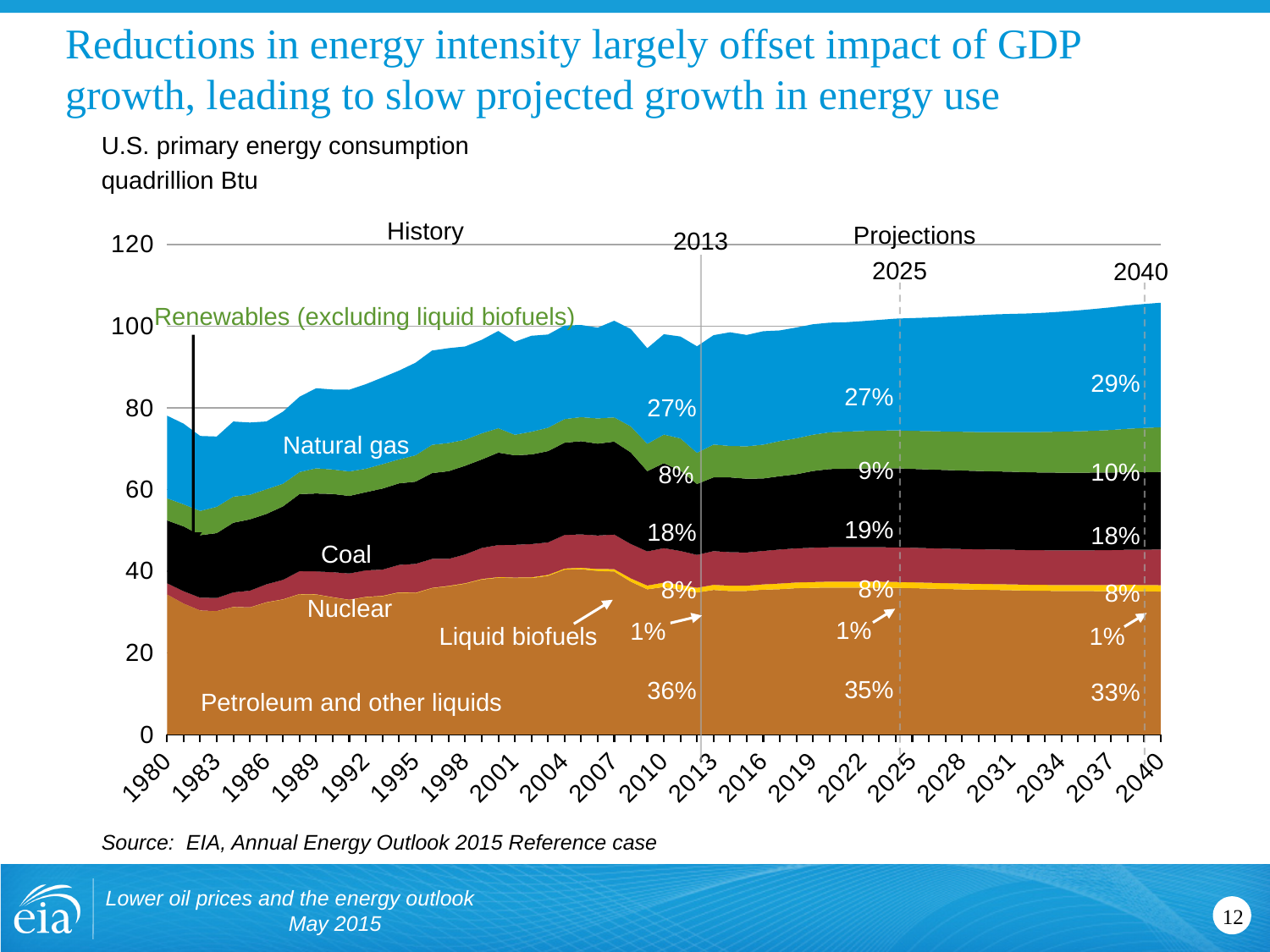
Is total U.S. primary energy consumption in 2040 greater or less than 100 quadrillion Btu? greater By how many percentage points does the natural gas share change between 2013 and 2040? 2 percentage points Which energy source has the largest share of U.S. primary energy consumption in 2013? Petroleum and other liquids What share of U.S. primary energy consumption do liquid biofuels account for in 2025? 1% Which energy source has the smallest share of U.S. primary energy consumption in 2040? Liquid biofuels How does the share of petroleum and other liquids change from 2013 to 2040? It falls, from 36% to 33% Which is larger in 2025, the share of coal or the share of nuclear? Coal What share of U.S. primary energy consumption does petroleum and other liquids account for in 2013? 36% What kind of chart is shown on the slide? Stacked area chart What share of U.S. primary energy consumption does natural gas account for in 2040? 29% What share of U.S. primary energy consumption do renewables (excluding liquid biofuels) account for in 2040? 10% What share of U.S. primary energy consumption does coal account for in 2025? 19%